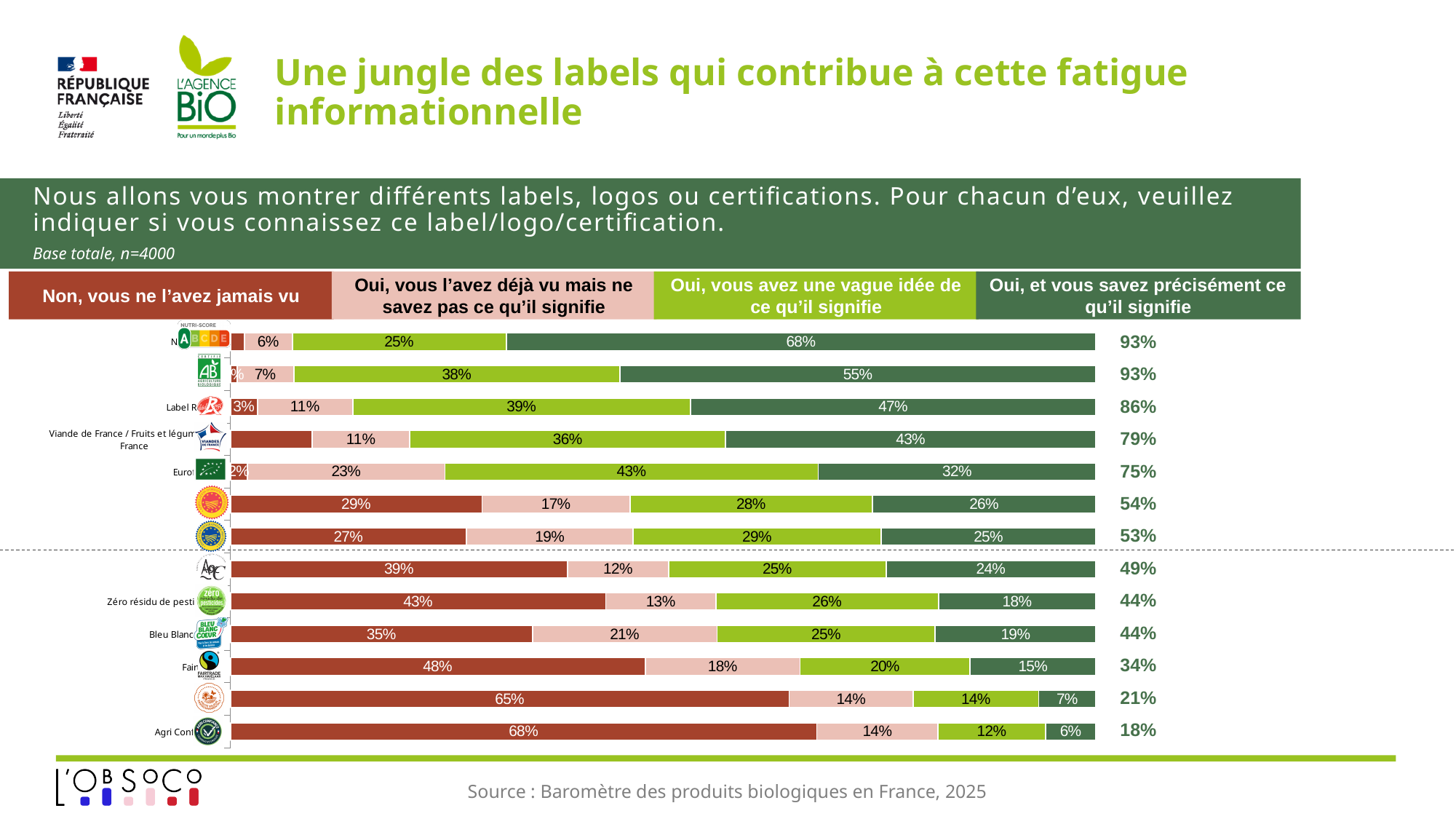
How many series does the legend list in the stacked bar chart? 4 What percentage of respondents say they know precisely what the Nutri-Score label means ("Oui, et vous savez précisément ce qu'il signifie")? 68% For Label Rouge, what is the difference between the share who know precisely what it means (47%) and the share with a vague idea (39%)? 8 percentage points What percentage of respondents have never seen the Agri Confiance label ("Non, vous ne l'avez jamais vu")? 68% Which label has the highest share of respondents who have never seen it? Agri Confiance For Bleu Blanc Coeur, what share has already seen the label but does not know what it means? 21% For "Viande de France / Fruits et légumes de France", what share has a vague idea of what the label means? 36% Which label has the highest share of respondents who know precisely what it means? Nutri-Score What kind of chart is used to show the label recognition results? Stacked bar chart Which has a larger share of respondents who have never seen it: Bleu Blanc Coeur or Zéro résidu de pesticides? Zéro résidu de pesticides How many labels/logos (rows) are plotted in the chart? 13 What total percentage is shown at the right of the bar for Label Rouge? 86%